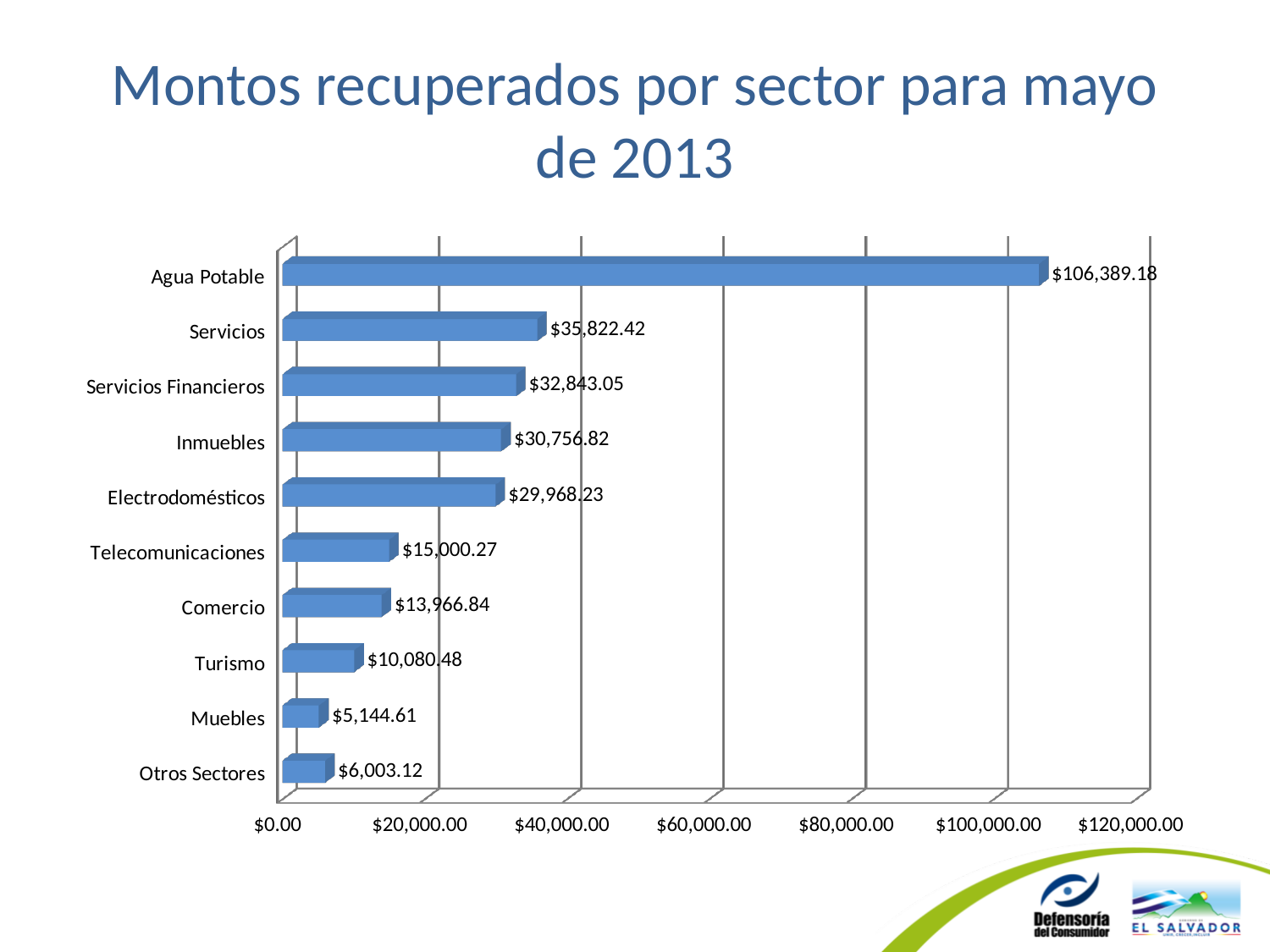
What kind of chart is shown on the slide? Bar chart What is the recovered amount for Agua Potable? $106,389.18 Which sector has the highest recovered amount? Agua Potable Which is larger, the amount for Servicios or for Servicios Financieros? Servicios What is the recovered amount for Muebles? $5,144.61 What is the difference between the amounts for Agua Potable and Servicios? $70,566.76 What is the title of the chart? Montos recuperados por sector para mayo de 2013 What is the difference between the amounts for Otros Sectores and Muebles? $858.51 How many sectors are shown in the chart? 10 What is the recovered amount for Telecomunicaciones? $15,000.27 Which sector has the lowest recovered amount? Muebles Is the value for Agua Potable greater or less than $100,000.00? greater